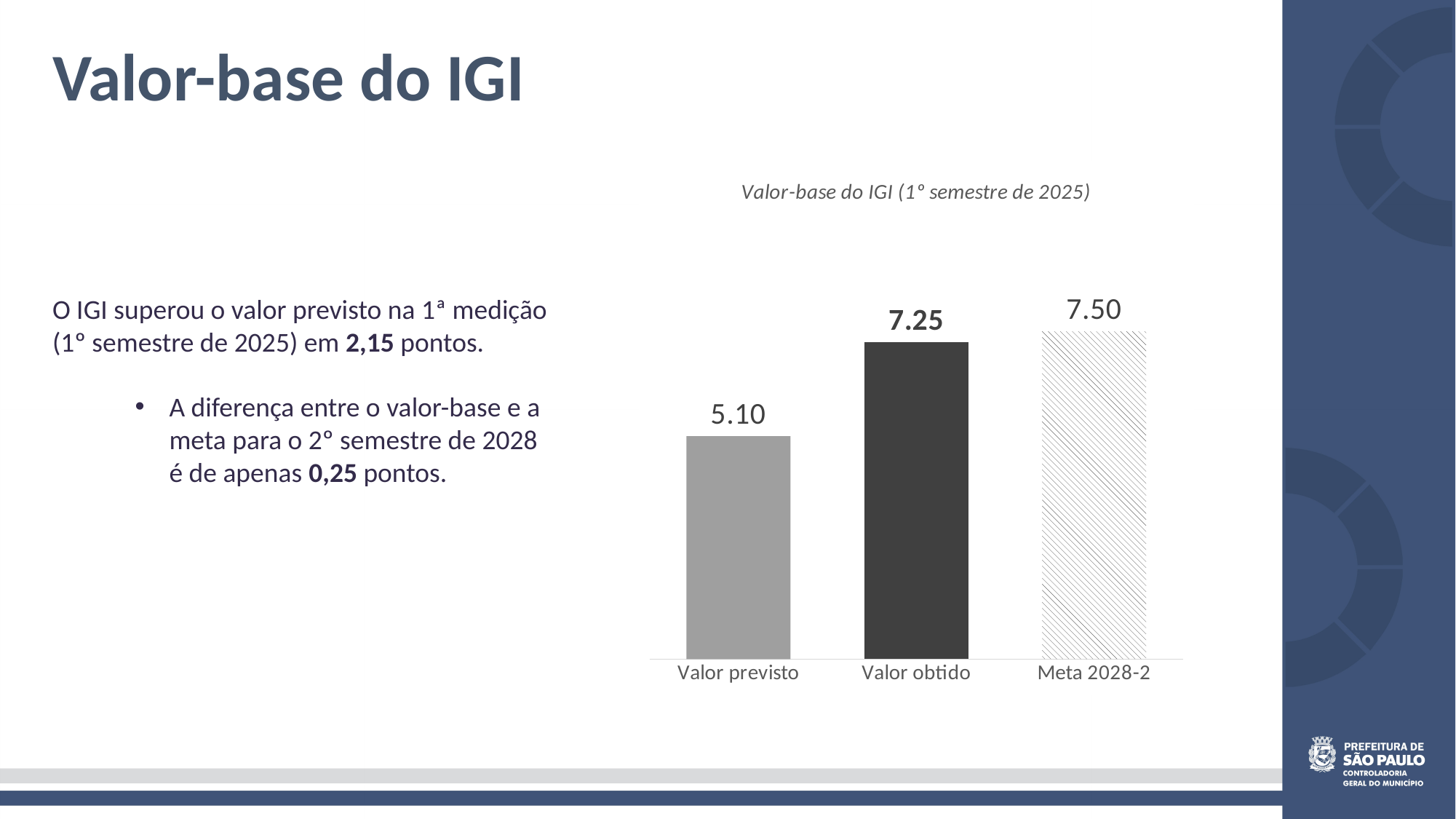
Which category has the lowest value? Valor previsto What is the value for Meta 2028-2? 7.50 What kind of chart is shown on the slide? Bar chart Which is larger, Valor previsto or Valor obtido? Valor obtido What is the title of the chart? Valor-base do IGI (1° semestre de 2025) Do the values rise or fall from left to right across the categories? Rise What is the value for Valor obtido? 7.25 What is the difference between Meta 2028-2 and Valor obtido? 0.25 How many categories are shown in the chart? 3 What is the difference between Valor obtido and Valor previsto? 2.15 What is the value for Valor previsto? 5.10 Which category has the highest value? Meta 2028-2